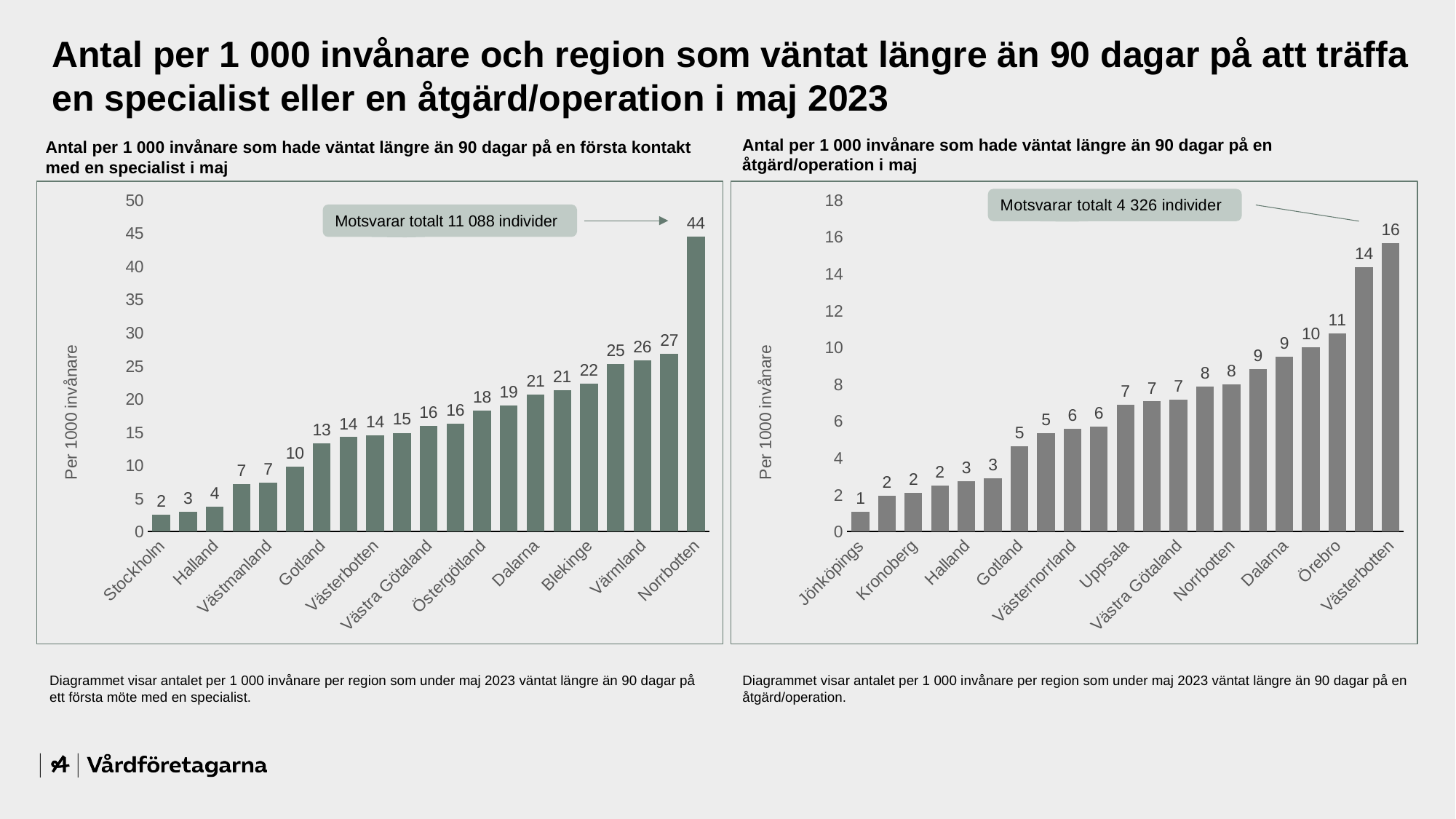
In the left chart (first contact with a specialist), which region has the lowest value? Stockholm In the left chart (first contact with a specialist), how many bars are plotted? 21 According to the annotation on the left chart, how many individuals in total does it correspond to? 11 088 individer What type of chart is the right chart (åtgärd/operation)? Bar chart In the right chart (åtgärd/operation), what is the value for Västerbotten? 16 In the right chart (åtgärd/operation), what is the value for Örebro? 11 In the right chart (åtgärd/operation), which region has the highest value? Västerbotten In the left chart (first contact with a specialist), which is larger, Blekinge or Dalarna? Blekinge In the left chart (first contact with a specialist), what is the difference between Norrbotten and Värmland? 18 In the left chart (first contact with a specialist), what is the value for Norrbotten? 44 In the right chart (åtgärd/operation), what is the difference between Dalarna and Gotland? 4 In the left chart (first contact with a specialist), what is the value for Gotland? 13